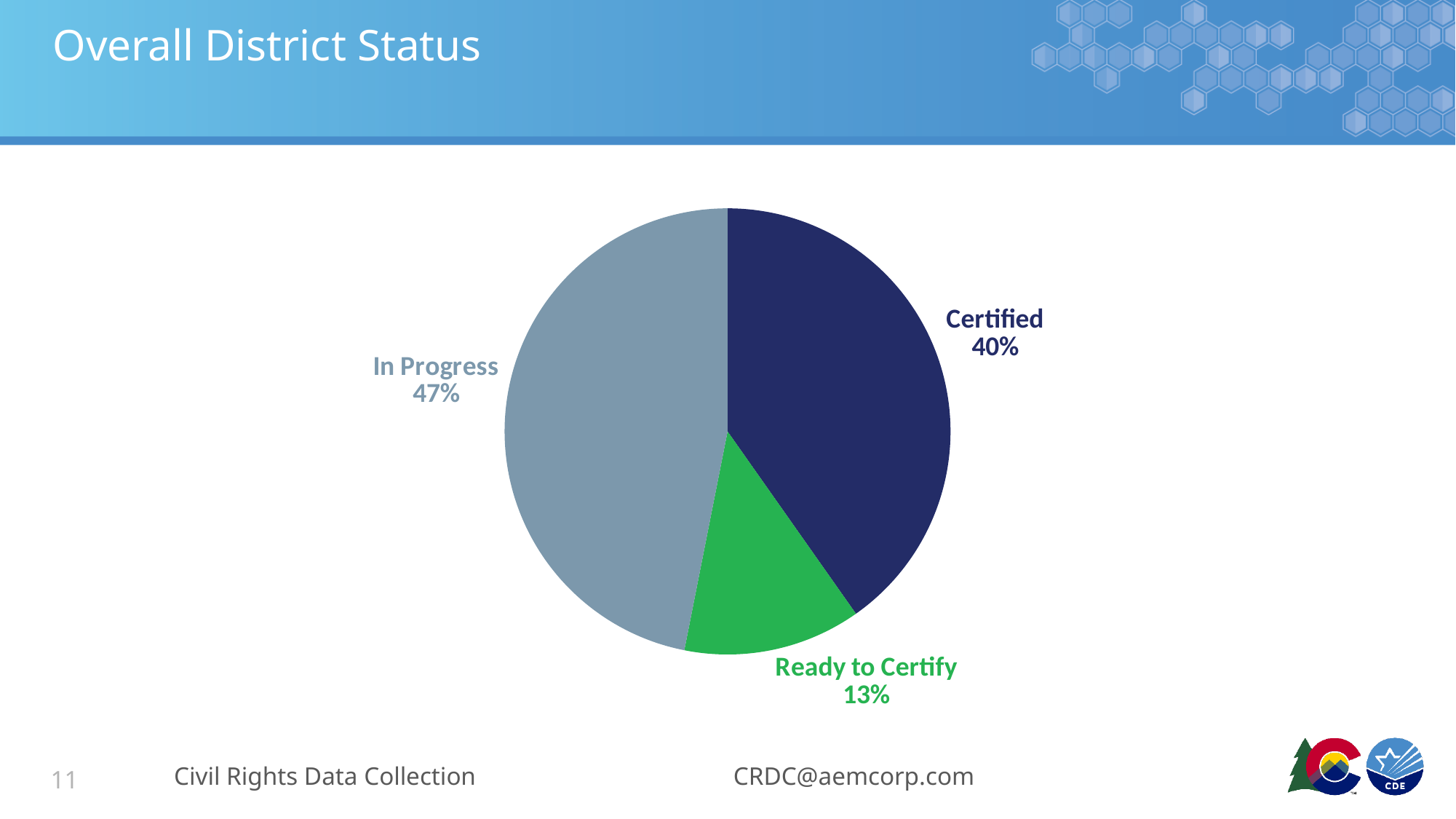
What kind of chart is shown on the slide? Pie chart What is the difference in percentage points between In Progress and Certified? 7 What is the difference in percentage points between Certified and Ready to Certify? 27 What share of the pie is labelled In Progress? 47% How many slices does the pie chart have? 3 Which category has the smallest slice of the pie? Ready to Certify What share of the pie is labelled Certified? 40% Which category has the largest slice of the pie? In Progress What colour is the Ready to Certify slice? Green Which is larger, the Certified slice or the Ready to Certify slice? Certified What is the title of the slide containing the pie chart? Overall District Status What share of the pie is labelled Ready to Certify? 13%